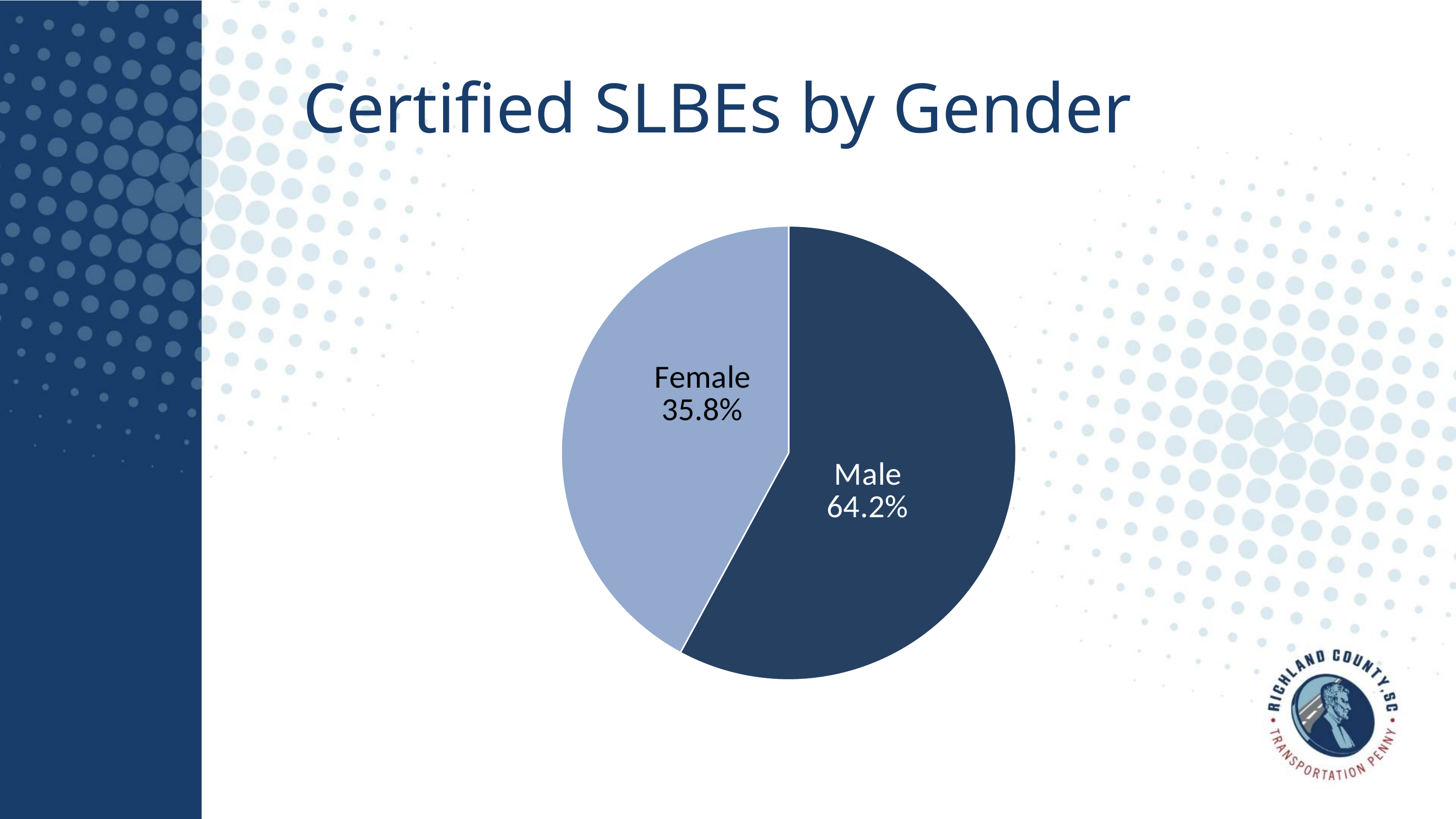
Which is larger, the Male share or the Female share? Male Is the Female share greater or less than 50%? less What share of certified SLBEs are Male? 64.2% Which slice is shown in the darker blue colour? Male Is the Male share greater or less than 50%? greater What kind of chart is shown on the slide? Pie chart Which gender has the smallest share of certified SLBEs? Female What is the difference in percentage points between the Male and Female shares? 28.4 How many slices does the pie chart have? 2 Which gender has the largest share of certified SLBEs? Male What share of certified SLBEs are Female? 35.8% What is the title of the slide? Certified SLBEs by Gender